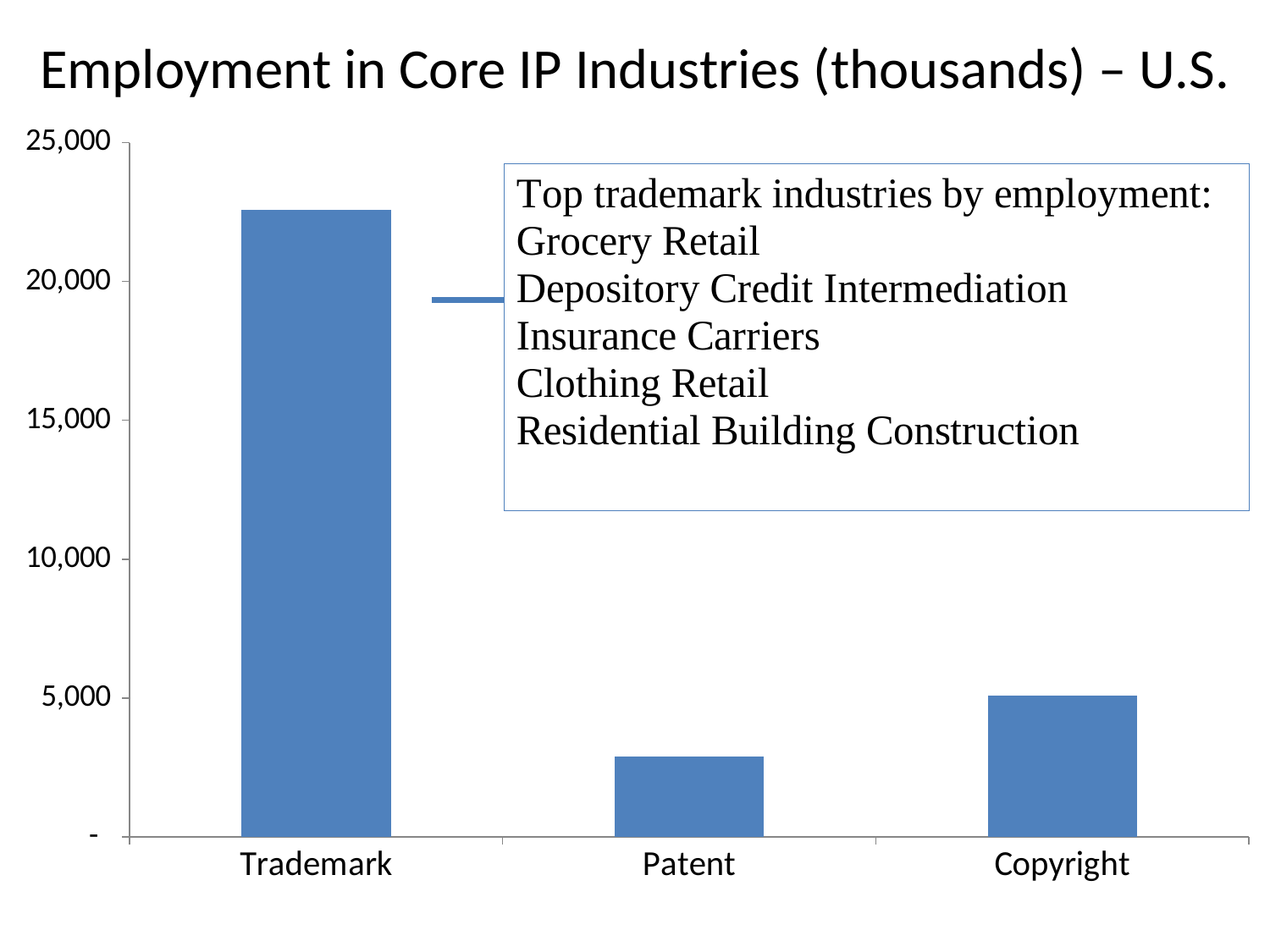
What kind of chart is shown on the slide? bar chart What is the title of the chart? Employment in Core IP Industries (thousands) – U.S. Is the value for Copyright greater or less than 10,000? less Which has higher employment, Trademark or Copyright? Trademark Which category has the highest employment? Trademark Which category has the lowest employment? Patent Which has higher employment, Copyright or Patent? Copyright Which industry is listed first in the text box of top trademark industries by employment? Grocery Retail Is the value for Trademark greater or less than 25,000? less How many categories are plotted on the x axis? 3 Is the value for Trademark greater or less than 20,000? greater